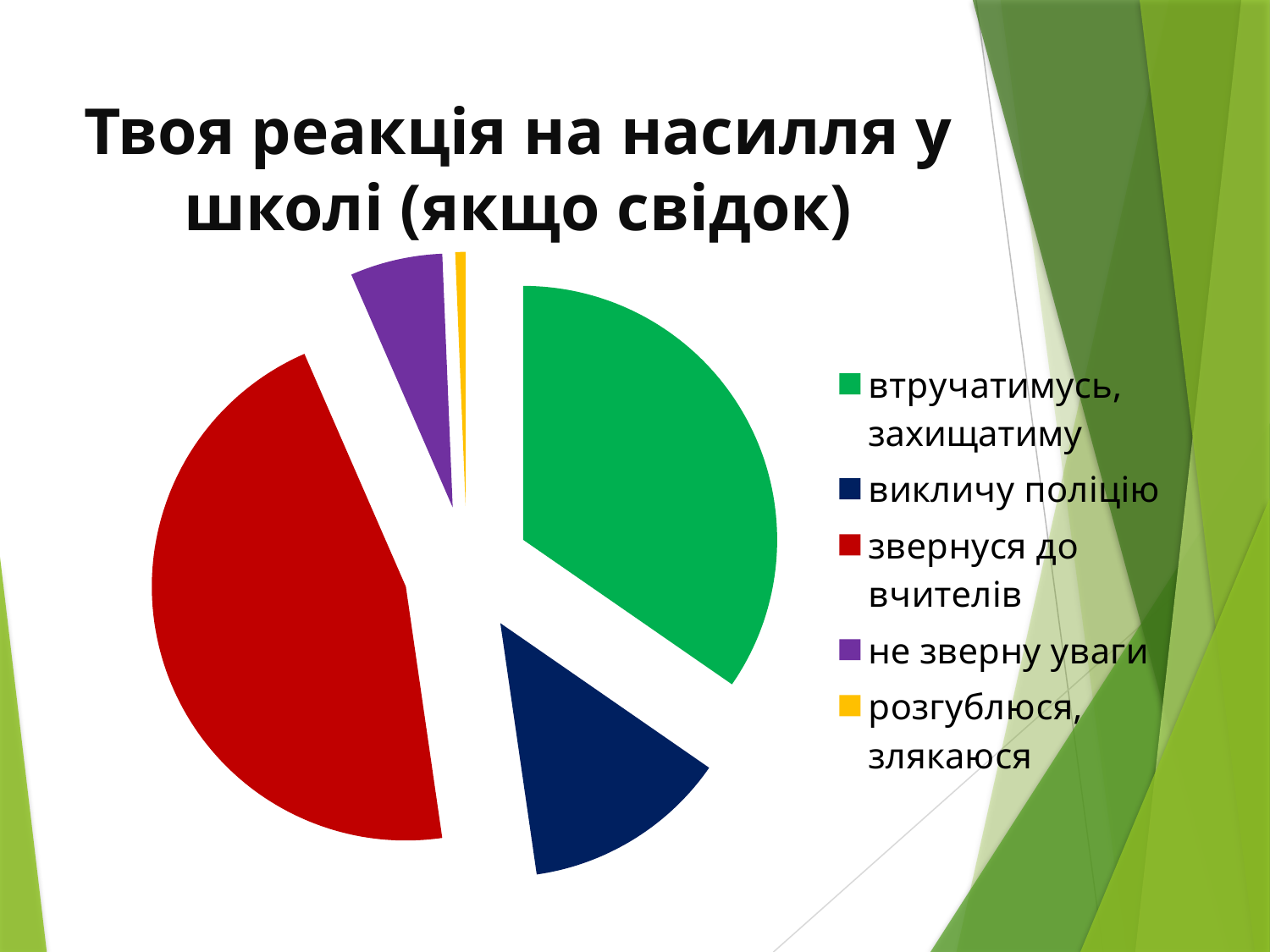
How many categories (slices) does the pie chart have? 5 What kind of chart is shown on the slide? pie chart Which slice is larger: "не зверну уваги" or "звернуся до вчителів"? звернуся до вчителів What is the title of the slide with the pie chart? Твоя реакція на насилля у школі (якщо свідок) Which slice is larger: "втручатимусь, захищатиму" or "викличу поліцію"? втручатимусь, захищатиму How many entries does the legend list? 5 Which category has the largest slice of the pie? звернуся до вчителів Which slice is larger: "викличу поліцію" or "не зверну уваги"? викличу поліцію Which category has the smallest slice of the pie? розгублюся, злякаюся What colour is the slice for "викличу поліцію"? dark blue